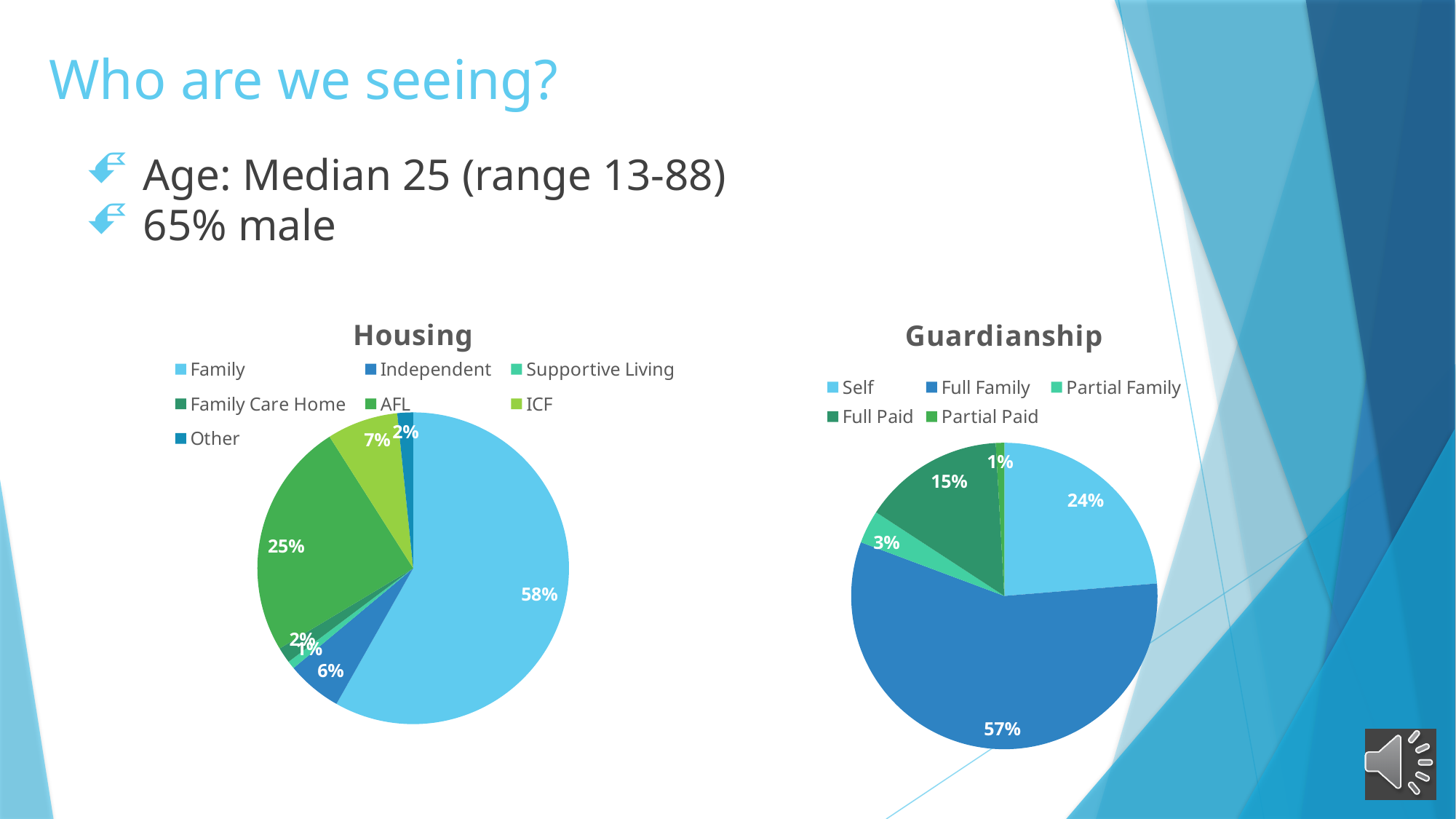
In the Housing chart, what percentage is shown for AFL? 25% In the Housing chart, what percentage is shown for ICF? 7% In the Guardianship chart, what percentage is shown for Self? 24% In the Housing chart, what percentage is shown for Family? 58% In the Housing chart, how many categories does the legend list? 7 In the Guardianship chart, what is the difference between Full Family and Self? 33% What type of chart is the Guardianship chart? Pie chart In the Housing chart, what percentage is shown for Independent? 6% In the Housing chart, which category has the largest slice? Family In the Guardianship chart, what percentage is shown for Full Family? 57% In the Guardianship chart, which category has the smallest slice? Partial Paid In the Guardianship chart, what percentage is shown for Full Paid? 15%